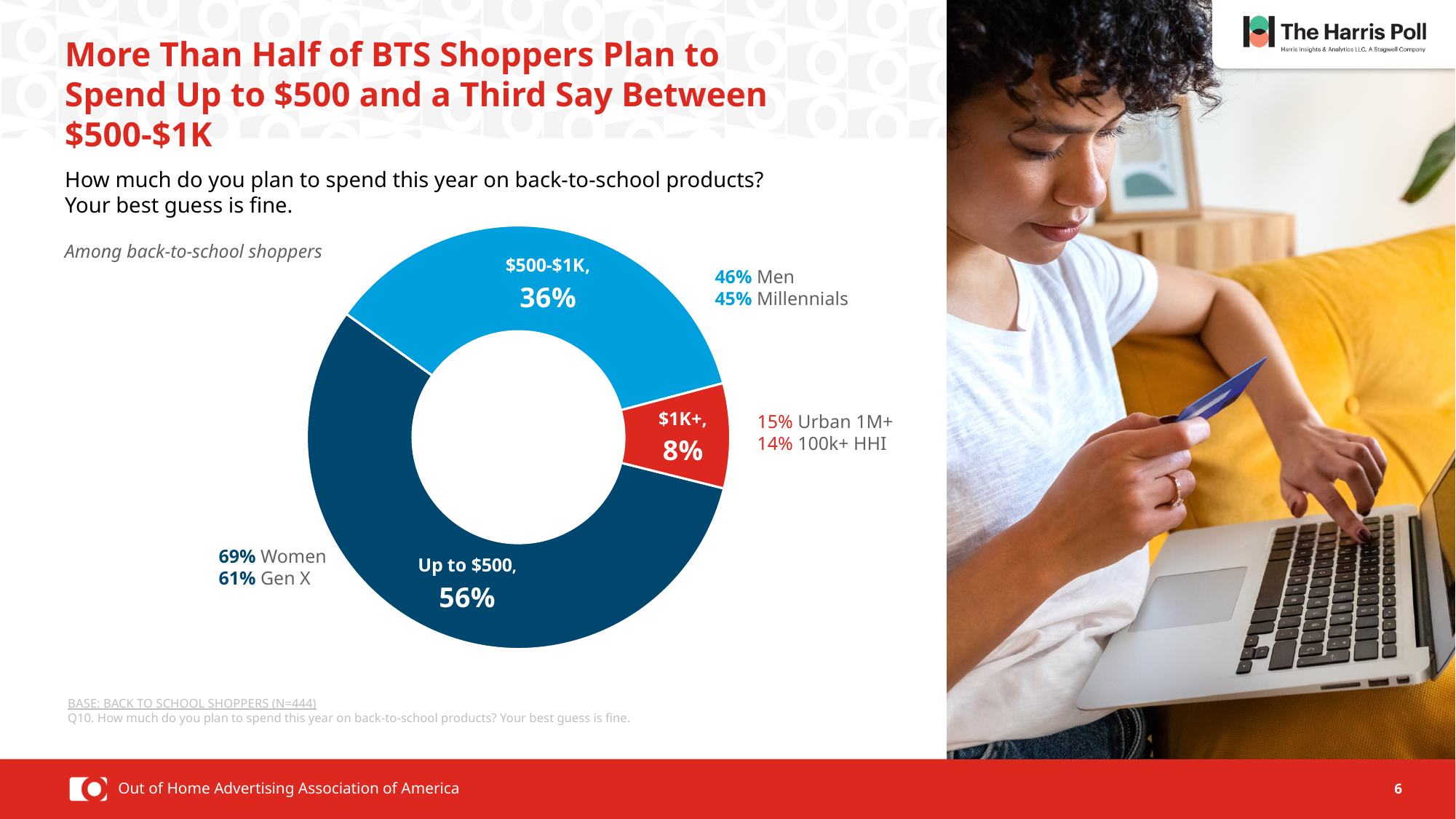
How many spending categories are shown in the donut chart? 3 Which spending category has the largest share of the donut chart? Up to $500 What share of back-to-school shoppers plan to spend $500-$1K? 36% What colour is the '$1K+' slice of the donut chart? Red What percentage of Women plan to spend up to $500, according to the callout next to the chart? 69% What is the difference in percentage points between the 'Up to $500' and '$500-$1K' slices? 20 What percentage of Millennials plan to spend $500-$1K, according to the callout next to the chart? 45% Which slice is larger: '$500-$1K' or '$1K+'? $500-$1K What type of chart is used to show planned back-to-school spending? Donut (pie) chart What share of back-to-school shoppers plan to spend $1K+? 8% What share of back-to-school shoppers plan to spend up to $500? 56% Which spending category has the smallest share of the donut chart? $1K+